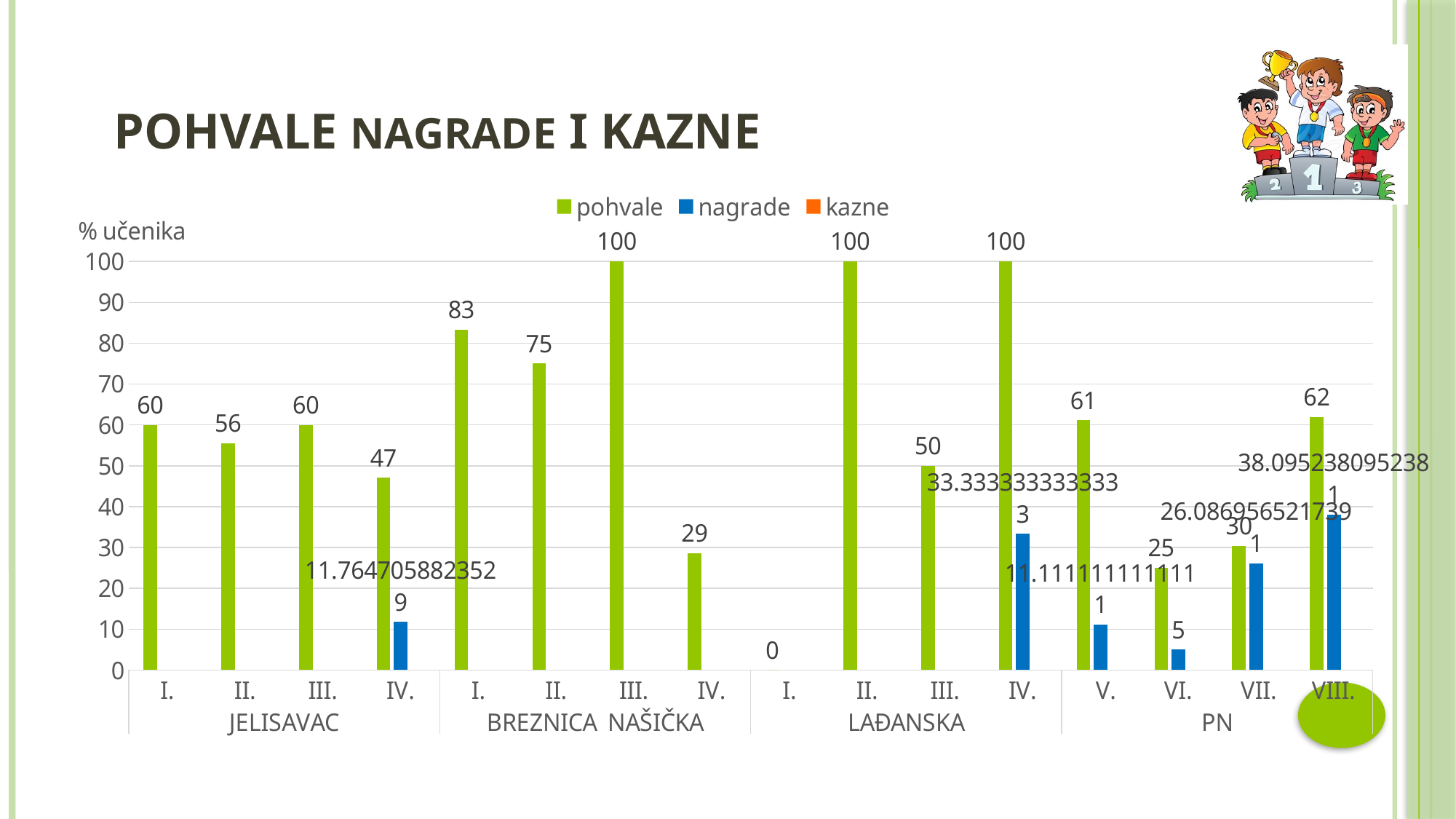
How many series does the legend list? 3 What is the pohvale value for class I. in LAĐANSKA? 0 What kind of chart is shown on the slide? bar chart What is the pohvale value for class II. in JELISAVAC? 56 What is the label on the vertical axis? % učenika What is the pohvale value for class IV. in BREZNICA NAŠIČKA? 29 Which is larger, the pohvale value for class V. in PN or for class VIII. in PN? VIII. in PN What is the nagrade value for class VI. in PN? 5 Which class in JELISAVAC has the lowest pohvale value? IV. How many classes (categories) are shown along the x axis? 16 What is the difference between the pohvale values for class I. and class II. in BREZNICA NAŠIČKA? 8 What is the pohvale value for class I. in BREZNICA NAŠIČKA? 83